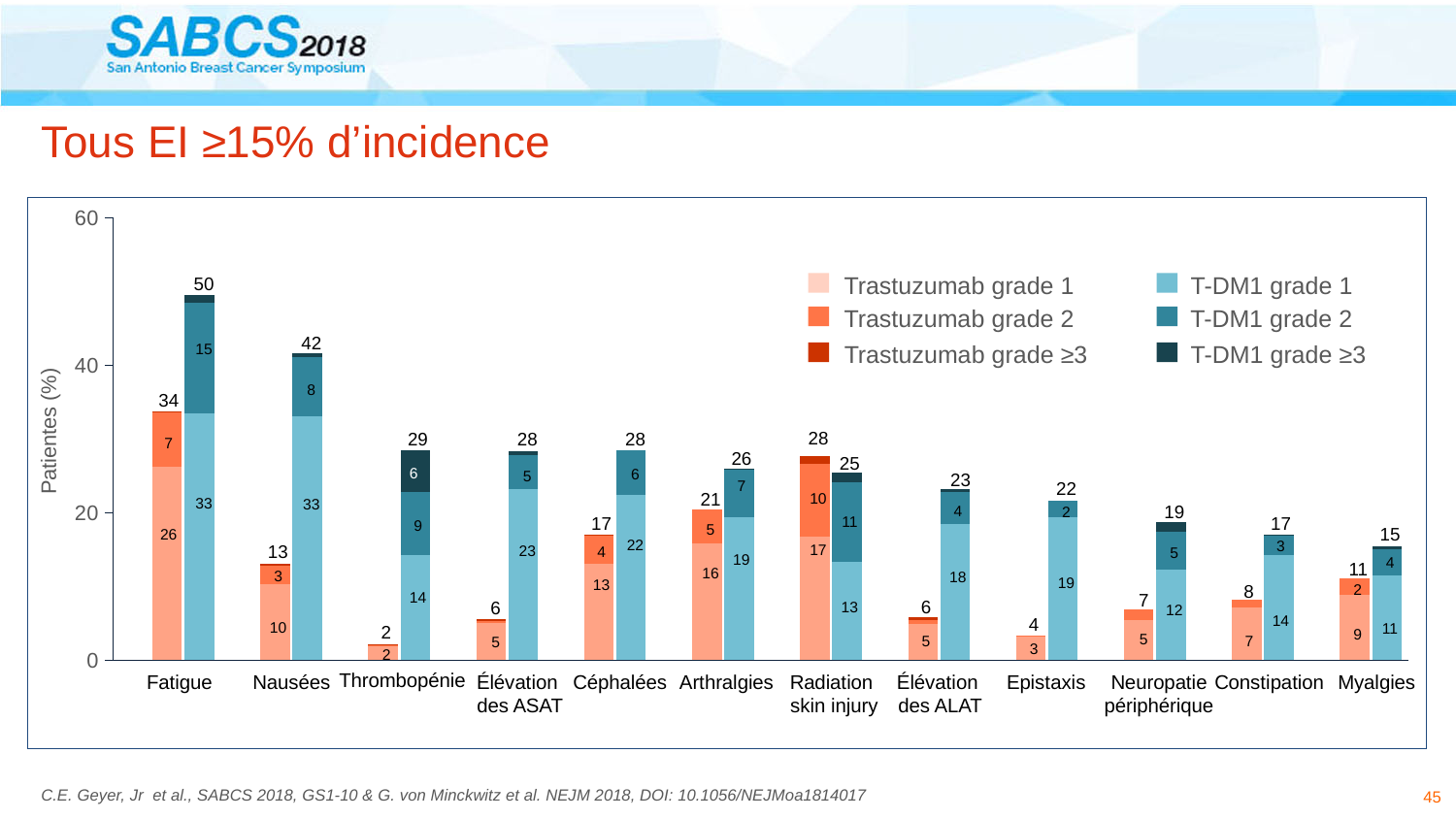
What is the title of the chart? Tous EI ≥15% d'incidence What kind of chart is shown on the slide? Stacked bar chart For Radiation skin injury, which is larger: the Trastuzumab total or the T-DM1 total? Trastuzumab total What is the total T-DM1 bar value for Fatigue? 50 Which category has the lowest Trastuzumab total? Thrombopénie Which category has the highest T-DM1 total? Fatigue What is the total Trastuzumab bar value for Radiation skin injury? 28 What is the total of the T-DM1 stacked bar for Thrombopénie? 29 What is the T-DM1 grade 1 value for Nausées? 33 What is the difference between the T-DM1 total and the Trastuzumab total for Nausées? 29 How many series does the legend list? 6 How many adverse event categories are shown on the x axis? 12